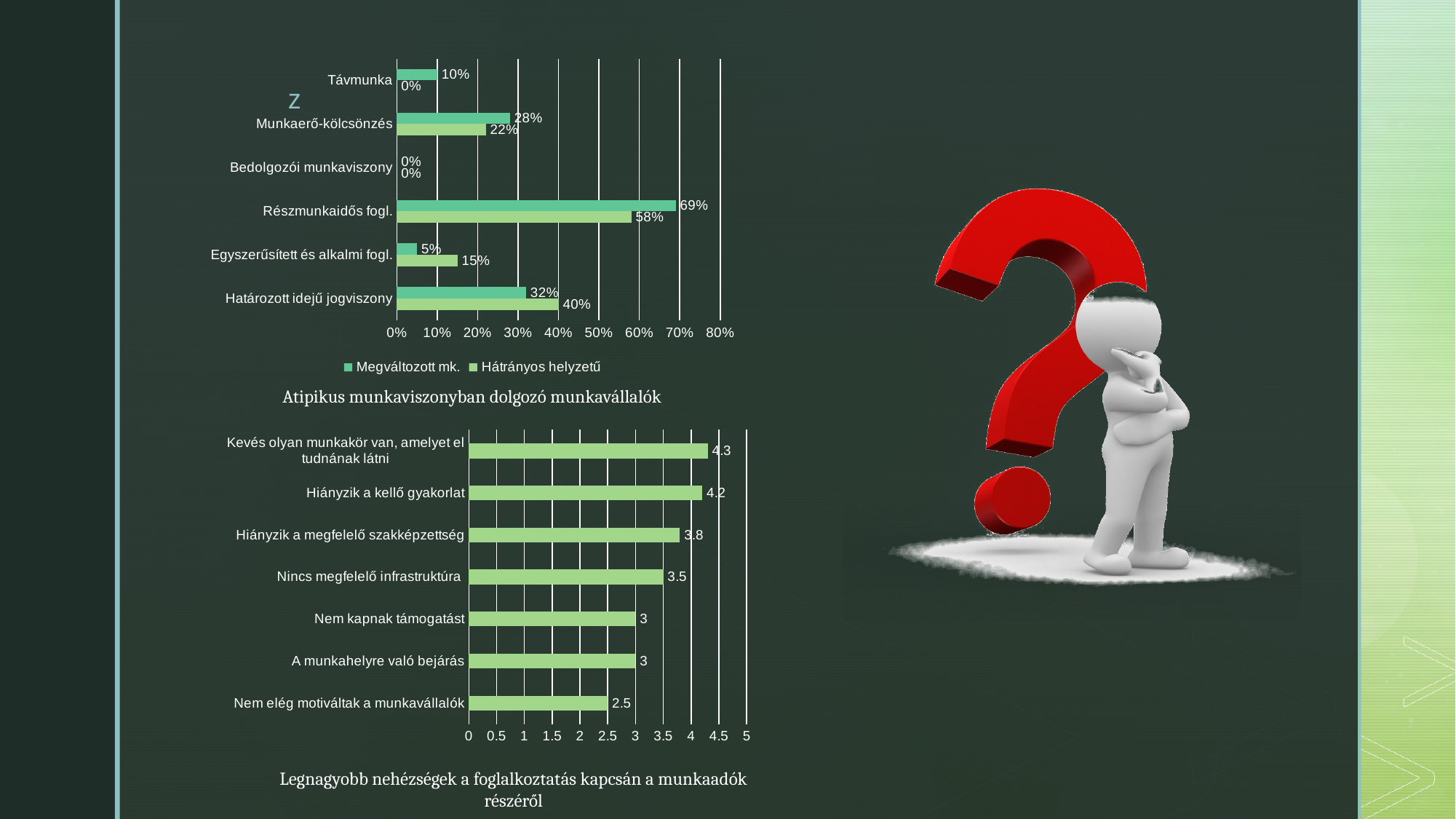
In the chart titled 'Legnagyobb nehézségek a foglalkoztatás kapcsán a munkaadók részéről', what is the difference between the values for Kevés olyan munkakör van, amelyet el tudnának látni and Nincs megfelelő infrastruktúra? 0.8 How many categories are shown in the chart titled 'Atipikus munkaviszonyban dolgozó munkavállalók'? 6 In the chart titled 'Atipikus munkaviszonyban dolgozó munkavállalók', what is the value for Határozott idejű jogviszony in the Hátrányos helyzetű series? 40% In the chart titled 'Atipikus munkaviszonyban dolgozó munkavállalók', which category has the highest value in the Hátrányos helyzetű series? Részmunkaidős fogl. In the chart titled 'Legnagyobb nehézségek a foglalkoztatás kapcsán a munkaadók részéről', which category has the lowest value? Nem elég motiváltak a munkavállalók In the chart titled 'Atipikus munkaviszonyban dolgozó munkavállalók', which is larger for Egyszerűsített és alkalmi fogl.: the Megváltozott mk. value or the Hátrányos helyzetű value? Hátrányos helyzetű What kind of chart is the chart titled 'Legnagyobb nehézségek a foglalkoztatás kapcsán a munkaadók részéről'? Bar chart How many categories are shown in the chart titled 'Legnagyobb nehézségek a foglalkoztatás kapcsán a munkaadók részéről'? 7 How many series does the legend of the chart titled 'Atipikus munkaviszonyban dolgozó munkavállalók' list? 2 In the chart titled 'Atipikus munkaviszonyban dolgozó munkavállalók', what is the difference between the Megváltozott mk. and Hátrányos helyzetű values for Részmunkaidős fogl.? 11% In the chart titled 'Atipikus munkaviszonyban dolgozó munkavállalók', what is the value for Részmunkaidős fogl. in the Megváltozott mk. series? 69% In the chart titled 'Legnagyobb nehézségek a foglalkoztatás kapcsán a munkaadók részéről', what is the value for Hiányzik a megfelelő szakképzettség? 3.8